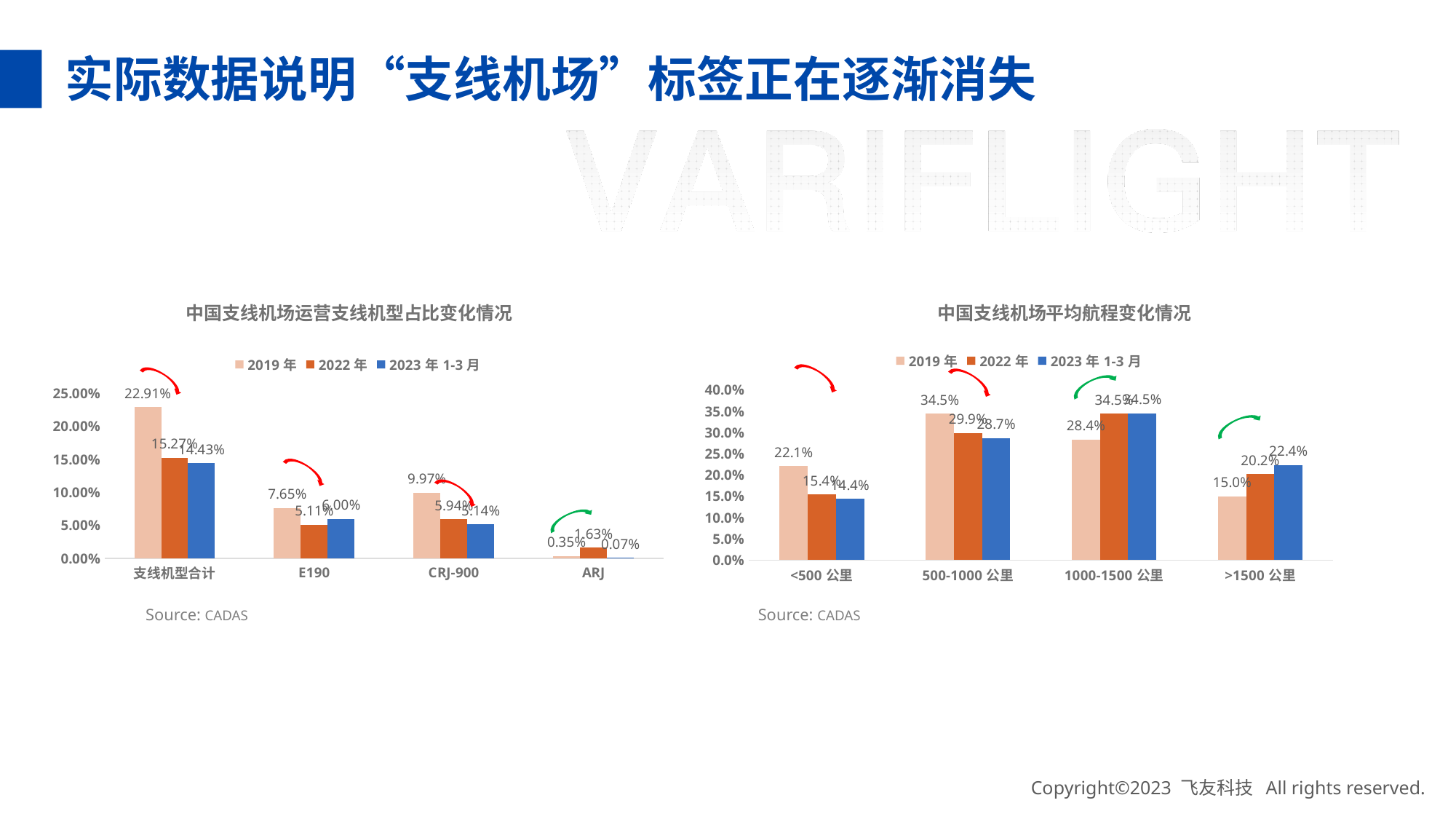
In the right chart (中国支线机场平均航程变化情况), what is the 2019 年 value for <500 公里? 22.1% In the right chart (中国支线机场平均航程变化情况), how many categories are shown on the x axis? 4 In the left chart (中国支线机场运营支线机型占比变化情况), how many series does the legend list? 3 In the right chart (中国支线机场平均航程变化情况), is the 2022 年 value for 1000-1500 公里 larger or smaller than the 2022 年 value for 500-1000 公里? larger In the right chart (中国支线机场平均航程变化情况), what is the 2023 年 1-3 月 value for >1500 公里? 22.4% What type of chart is the right chart (中国支线机场平均航程变化情况)? bar chart In the left chart (中国支线机场运营支线机型占比变化情况), which category has the lowest 2019 年 value? ARJ In the left chart (中国支线机场运营支线机型占比变化情况), what is the difference between the 2019 年 and 2022 年 values for CRJ-900? 4.03% In the right chart (中国支线机场平均航程变化情况), which category has the highest 2019 年 value? 500-1000 公里 In the left chart (中国支线机场运营支线机型占比变化情况), what is the 2023 年 1-3 月 value for E190? 6.00% In the left chart (中国支线机场运营支线机型占比变化情况), what is the 2019 年 value for 支线机型合计? 22.91% In the left chart (中国支线机场运营支线机型占比变化情况), what is the 2022 年 value for ARJ? 1.63%